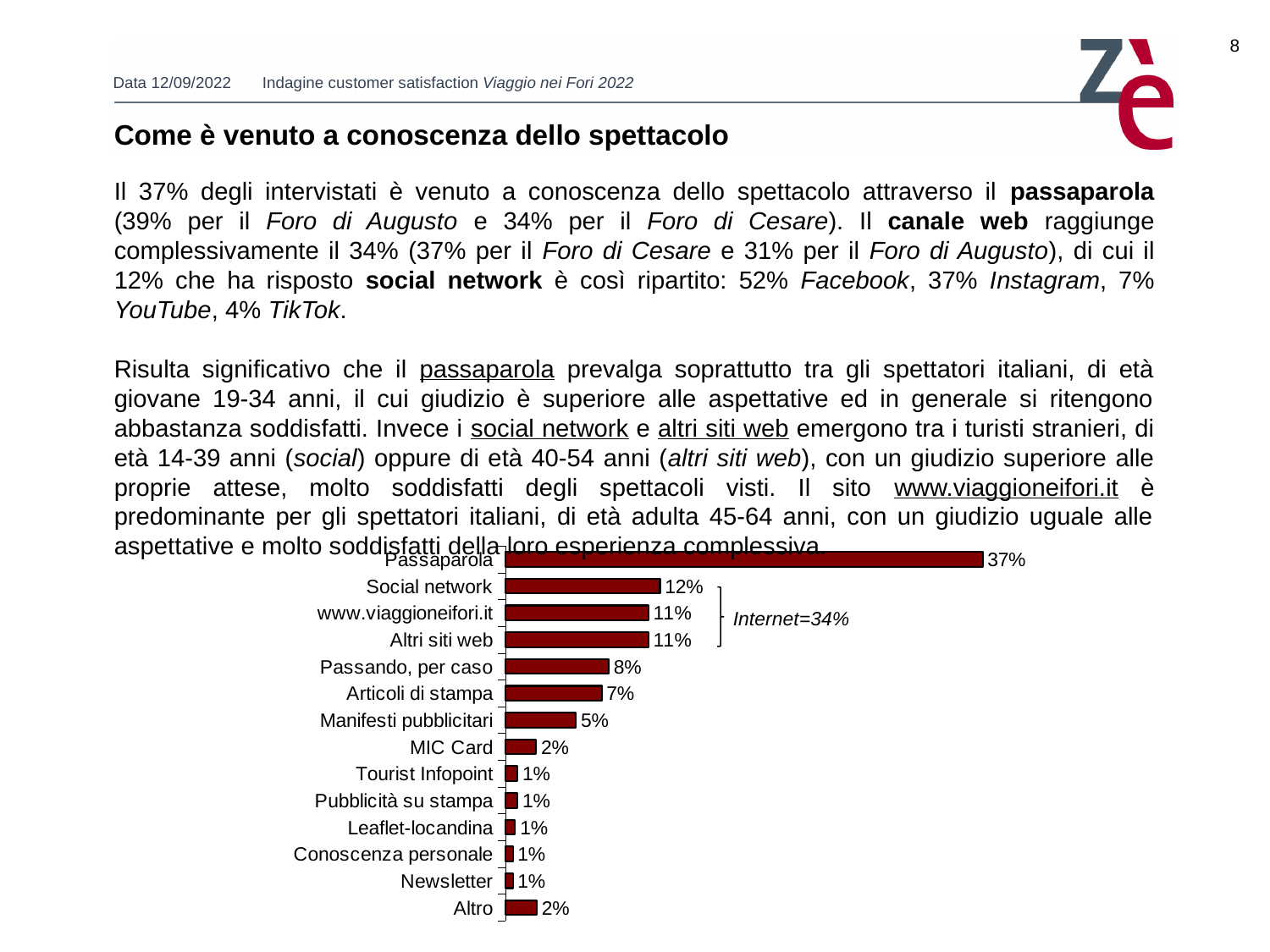
What is the difference between the values for Passando, per caso and Manifesti pubblicitari? 3% What is the value for Social network? 12% What is the value for Passaparola? 37% What is the value for Manifesti pubblicitari? 5% What is the value for MIC Card? 2% What is the value for www.viaggioneifori.it? 11% Which is larger, the value for Passando, per caso or the value for Articoli di stampa? Passando, per caso What total does the bracket annotation next to the Social network, www.viaggioneifori.it and Altri siti web bars give for Internet? Internet=34% Which category has the highest value? Passaparola What kind of chart is shown on the slide? bar chart How many categories are shown in the chart? 14 What is the difference between the values for Passaparola and Social network? 25%